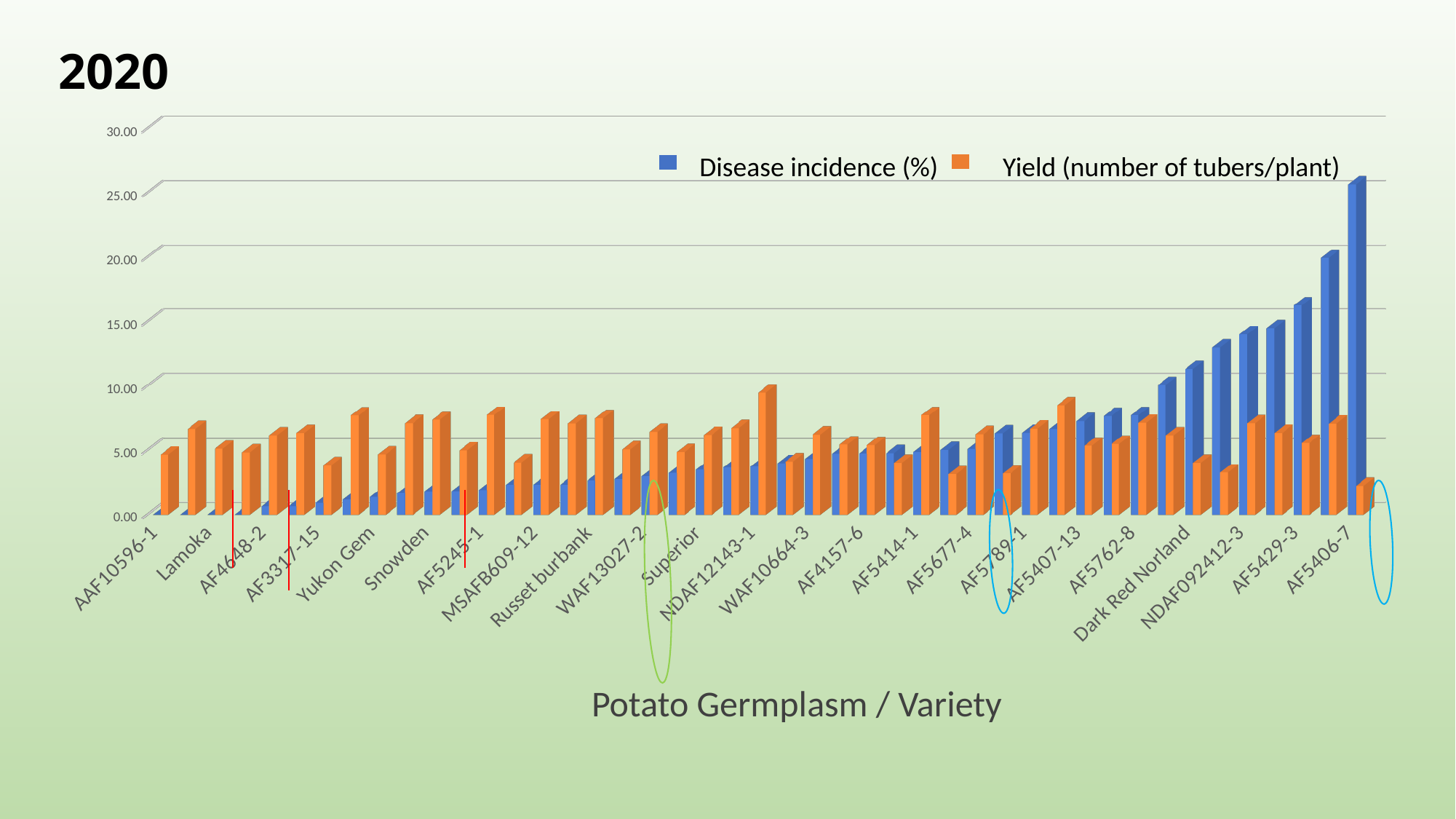
Is the Disease incidence (%) for AF5429-3 greater or less than 15? greater For Lamoka, which is larger: Disease incidence (%) or Yield (number of tubers/plant)? Yield (number of tubers/plant) How many series does the legend list? 2 What type of chart is shown on the slide? bar chart Does Disease incidence (%) generally rise or fall from left to right along the x axis? rise Is the Disease incidence (%) for AAF10596-1 greater or less than 5? less What is the x-axis title of the chart? Potato Germplasm / Variety Is the Disease incidence (%) for AF5406-7 greater or less than 20? greater For AF5406-7, which is larger: Disease incidence (%) or Yield (number of tubers/plant)? Disease incidence (%) What colour represents the Yield (number of tubers/plant) series? orange Which category has the highest Disease incidence (%)? AF5406-7